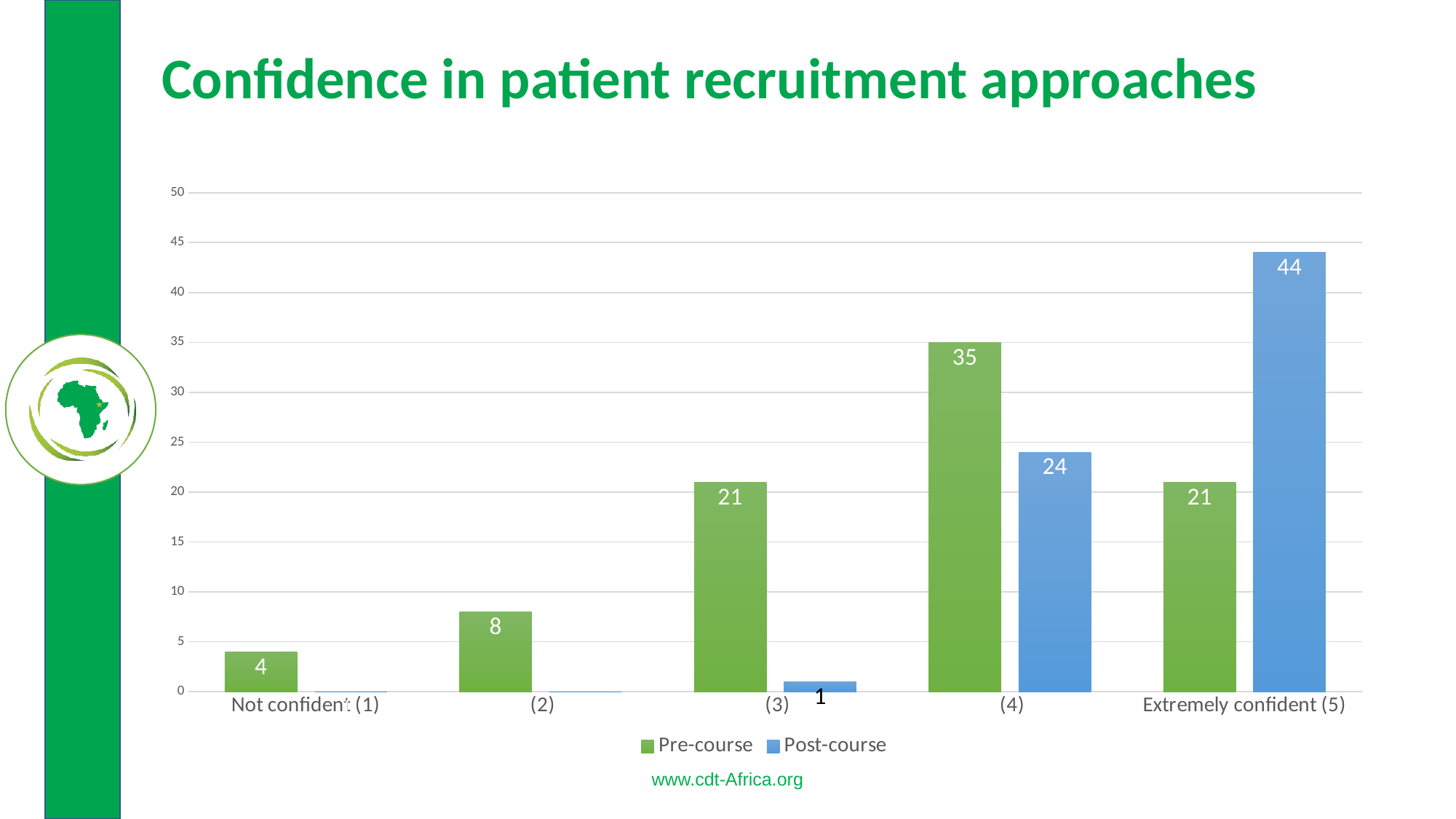
Which category has the highest Pre-course value? (4) How many categories are shown on the x axis? 5 What is the Post-course value for Extremely confident (5)? 44 Which category has the highest Post-course value? Extremely confident (5) How many series does the legend list? 2 What is the Pre-course value for Not confident (1)? 4 What is the Pre-course value for (4)? 35 What kind of chart is shown on the slide? Bar chart Which category has the lowest Pre-course value? Not confident (1) What is the difference between the Post-course and Pre-course values for Extremely confident (5)? 23 Which is larger for (4): the Pre-course value or the Post-course value? Pre-course What is the Post-course value for (3)? 1